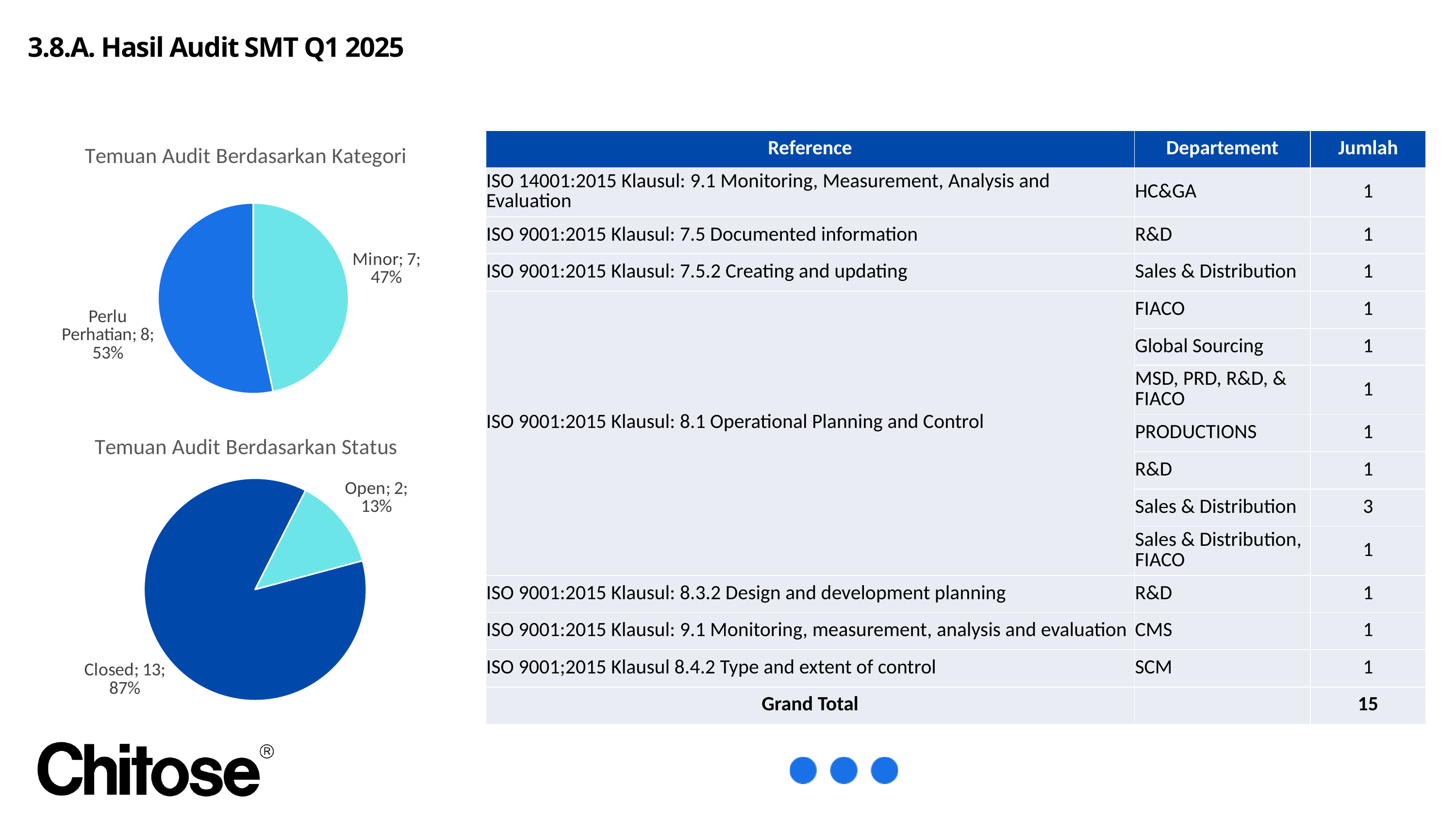
In the 'Temuan Audit Berdasarkan Status' chart, what is the value for Open? 2 In the 'Temuan Audit Berdasarkan Status' chart, what share of the pie is Open? 13% In the 'Temuan Audit Berdasarkan Status' chart, which category is the smallest? Open In the 'Temuan Audit Berdasarkan Kategori' chart, what is the difference between Perlu Perhatian and Minor? 1 In the 'Temuan Audit Berdasarkan Kategori' chart, what share of the pie is Perlu Perhatian? 53% In the 'Temuan Audit Berdasarkan Kategori' chart, what is the value for Perlu Perhatian? 8 In the 'Temuan Audit Berdasarkan Kategori' chart, what is the value for Minor? 7 What kind of chart is 'Temuan Audit Berdasarkan Status'? Pie chart How many categories does the 'Temuan Audit Berdasarkan Kategori' chart show? 2 In the 'Temuan Audit Berdasarkan Status' chart, what is the difference between Closed and Open? 11 In the 'Temuan Audit Berdasarkan Status' chart, what is the value for Closed? 13 In the 'Temuan Audit Berdasarkan Kategori' chart, which category is the largest? Perlu Perhatian